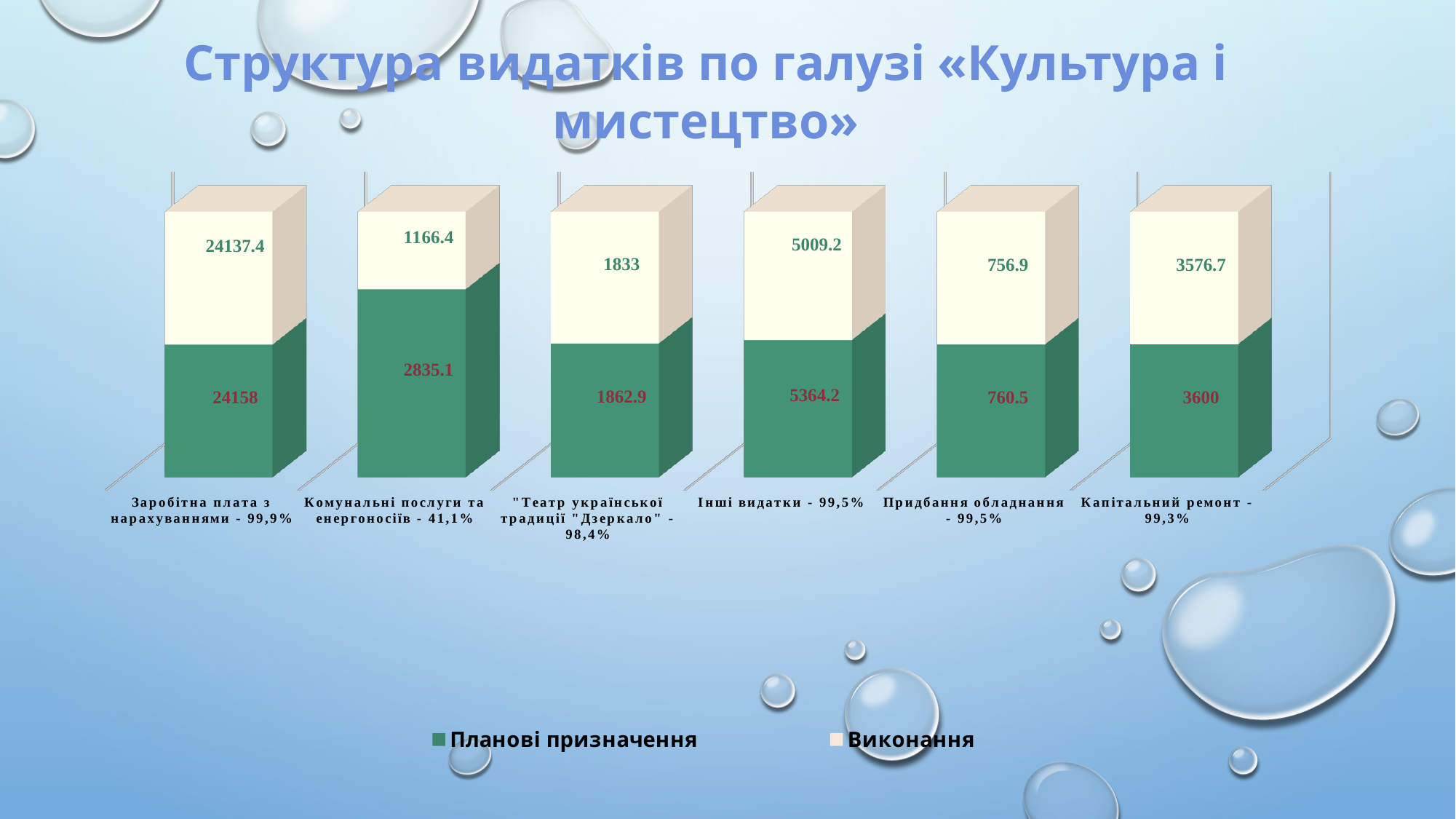
What is the value of Виконання for Капітальний ремонт? 3576.7 What kind of chart is shown on the slide? Stacked bar chart What is the value of Планові призначення for Заробітна плата з нарахуваннями? 24158 What is the difference between Планові призначення and Виконання for Інші видатки? 355 Which category has the lowest Виконання value? Придбання обладнання What is the difference between Планові призначення and Виконання for Комунальні послуги та енергоносіїв? 1668.7 How many series does the legend list? 2 Which category has the highest Планові призначення value? Заробітна плата з нарахуваннями Which is larger: the Виконання value for Капітальний ремонт or for Інші видатки? Інші видатки What is the value of Планові призначення for Інші видатки? 5364.2 What is the value of Виконання for Комунальні послуги та енергоносіїв? 1166.4 How many categories are shown on the x axis? 6